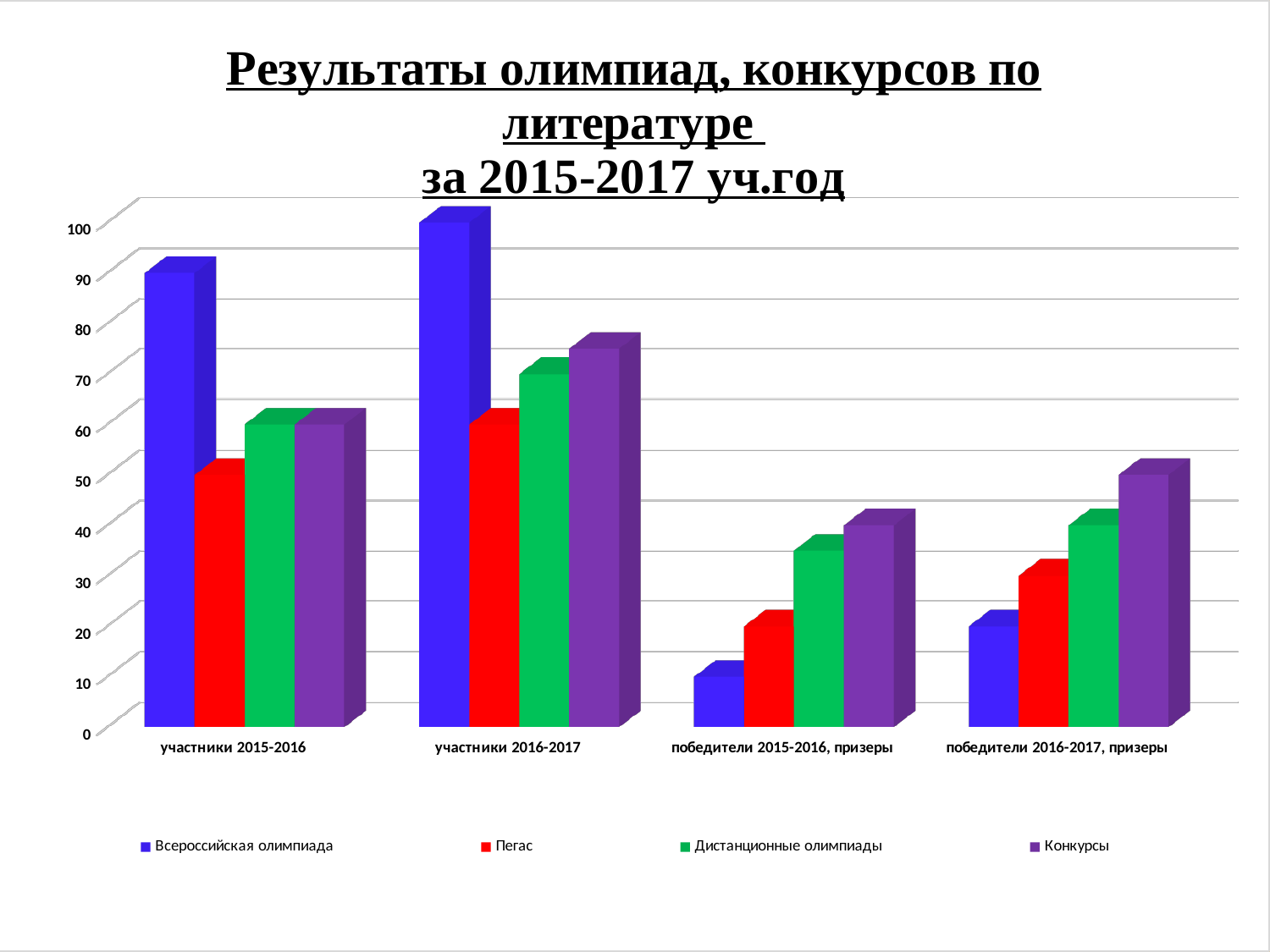
Is the value for Пегас in участники 2015-2016 greater or less than 60? less In the category участники 2015-2016, which is larger: Всероссийская олимпиада or Пегас? Всероссийская олимпиада What colour represents the series Конкурсы in the legend? Purple Which series and category has the tallest bar in the whole chart? Всероссийская олимпиада, участники 2016-2017 Is the value for Конкурсы in победители 2016-2017, призеры greater or less than 40? greater What kind of chart is shown on the slide? Bar chart In the category победители 2015-2016, призеры, which series has the lowest bar? Всероссийская олимпиада In the category участники 2016-2017, which series has the highest bar? Всероссийская олимпиада Does the value for Всероссийская олимпиада rise or fall from участники 2015-2016 to участники 2016-2017? rise How many series does the legend list? 4 How many categories are shown along the x axis? 4 Is the value for Всероссийская олимпиада in победители 2015-2016, призеры greater or less than 20? less